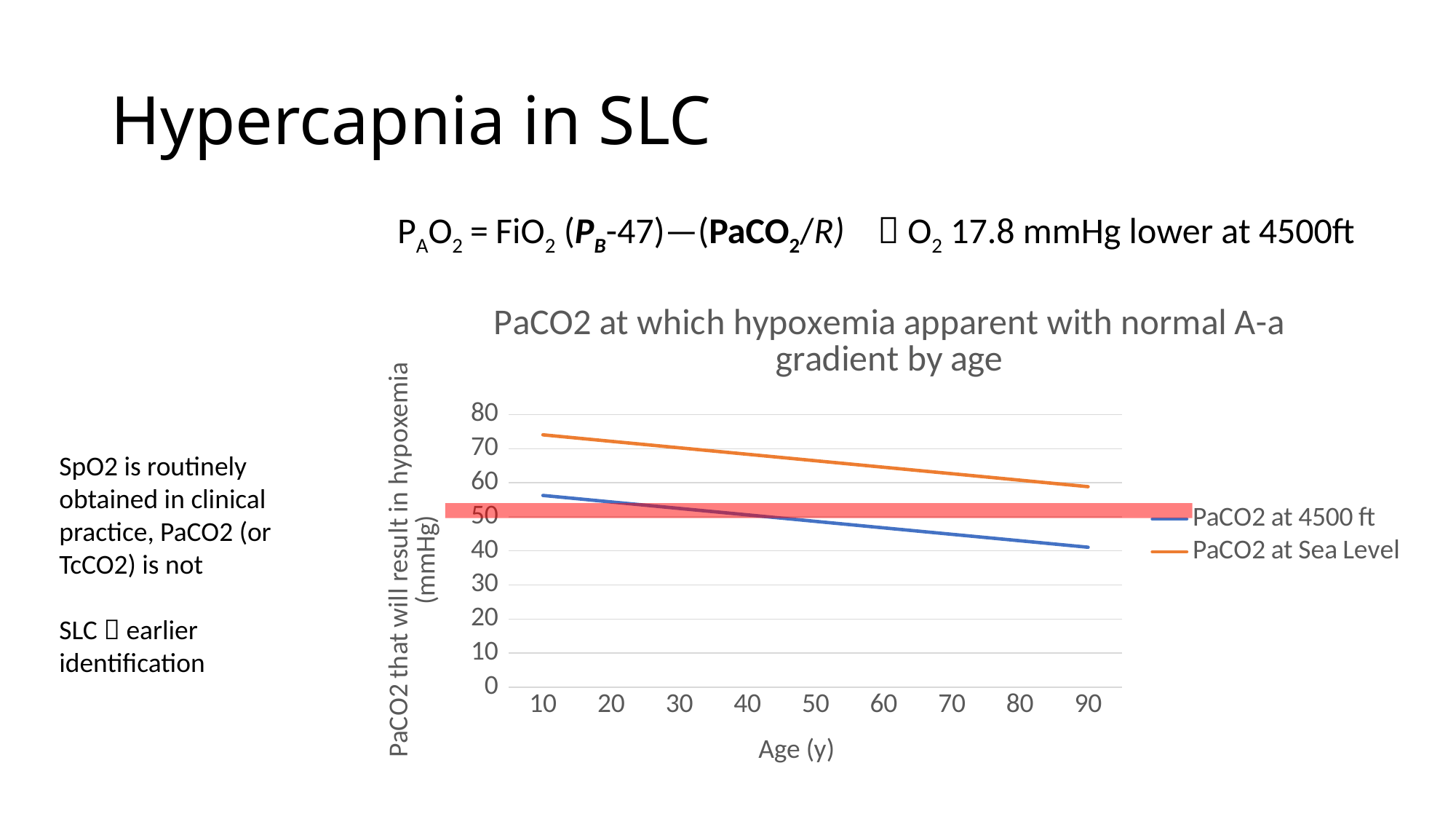
What kind of chart is shown on the slide? line chart Which series has the higher value at age 50, PaCO2 at 4500 ft or PaCO2 at Sea Level? PaCO2 at Sea Level Is the value for PaCO2 at 4500 ft at age 10 greater or less than 50? greater Is the value for PaCO2 at Sea Level at age 90 greater or less than 50? greater Do the values for PaCO2 at Sea Level rise or fall as age increases? fall Do the values for PaCO2 at 4500 ft rise or fall as age increases? fall Is the value for PaCO2 at Sea Level at age 10 greater or less than 70? greater How many age values are marked on the x axis of the chart? 9 How many series does the chart legend list? 2 What is the title of the chart? PaCO2 at which hypoxemia apparent with normal A-a gradient by age What are the two series named in the chart legend? PaCO2 at 4500 ft and PaCO2 at Sea Level